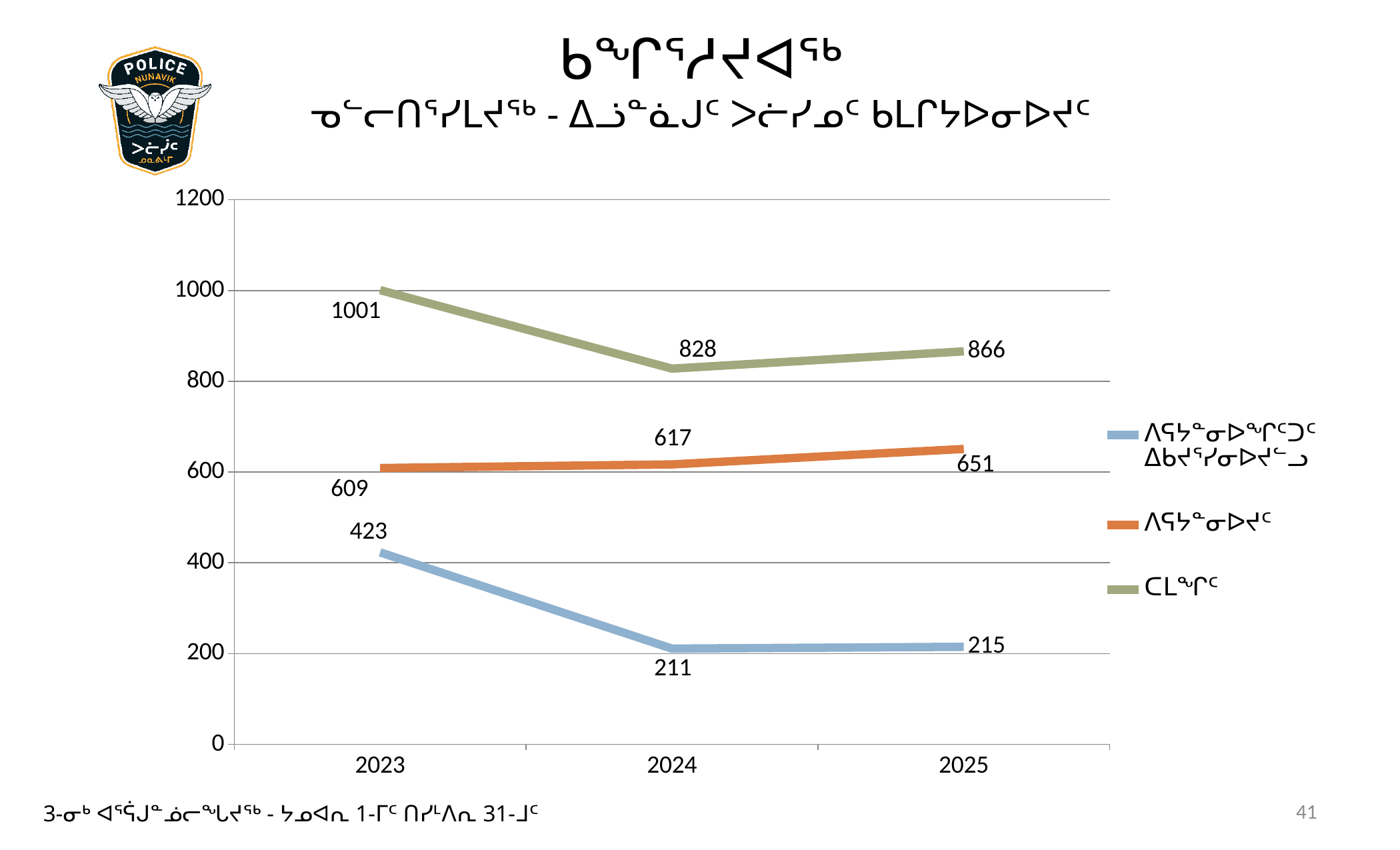
What is the value of the blue line in 2024? 211 What is the value of the orange line in 2025? 651 In 2025, which line has the larger value, the orange line or the blue line? orange line In which year does the blue line have its lowest value? 2024 Does the orange line rise or fall from 2023 to 2025? rises How many series does the legend list? 3 How many years are shown on the x axis? 3 What is the value of the green line in 2023? 1001 By how much did the green line fall from 2023 to 2024? 173 In which year does the green line reach its highest value? 2023 What is the difference between the blue line's 2023 value and its 2025 value? 208 What type of chart is shown on the slide? line chart